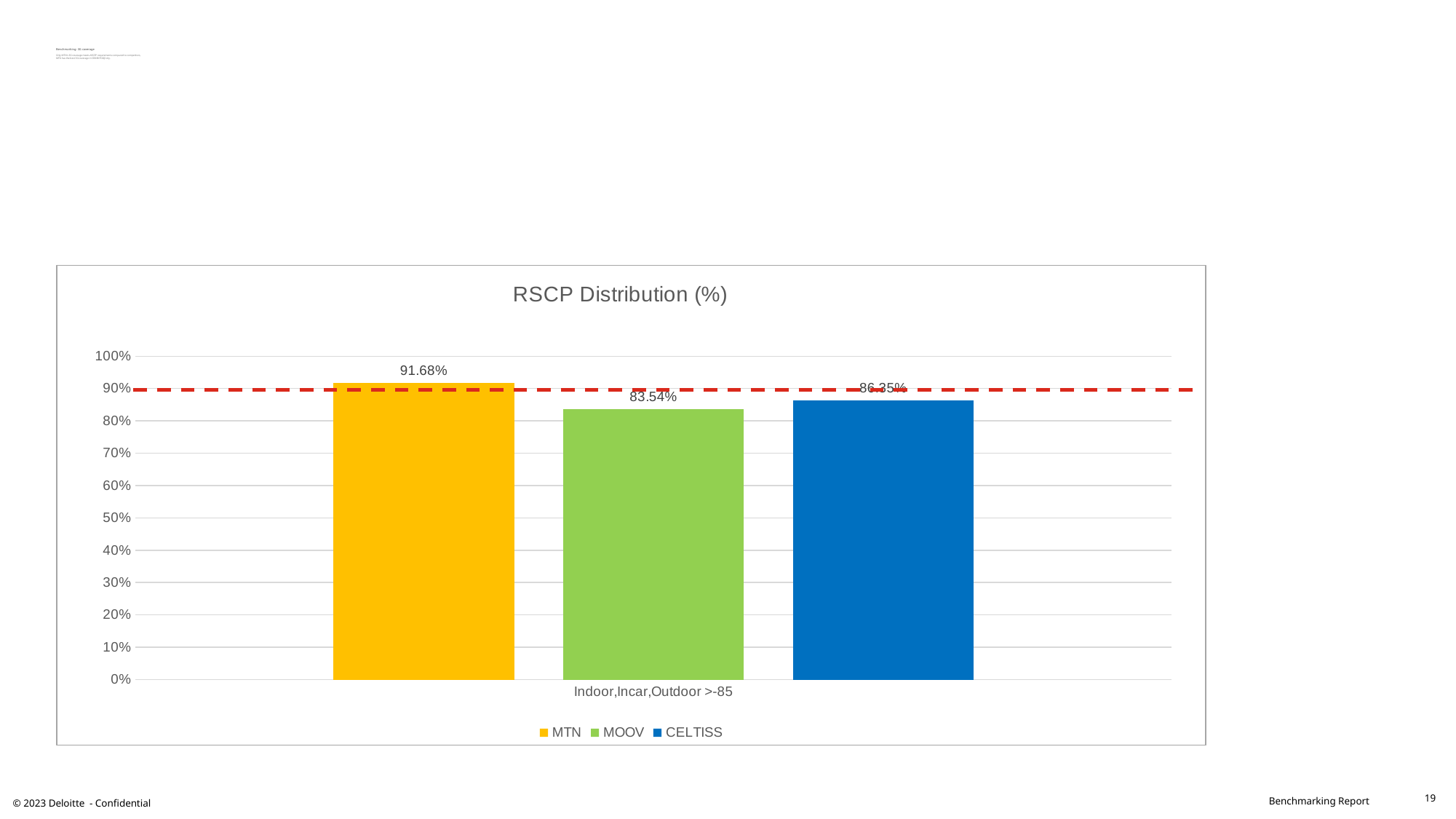
How many series does the legend of the RSCP Distribution (%) chart list? 3 Which operator has the lowest value in the RSCP Distribution (%) chart? MOOV Which is larger in the RSCP Distribution (%) chart, the value for CELTISS or the value for MOOV? CELTISS What is the difference between the MTN and MOOV values in the RSCP Distribution (%) chart? 8.14% What is the category label on the x axis of the RSCP Distribution (%) chart? Indoor,Incar,Outdoor >-85 Is the value for CELTISS in the RSCP Distribution (%) chart greater or less than 90%? less What kind of chart is the RSCP Distribution (%) chart? Bar chart Which operator has the highest value in the RSCP Distribution (%) chart? MTN What is the value for MOOV in the RSCP Distribution (%) chart? 83.54% What is the value for CELTISS in the RSCP Distribution (%) chart? 86.35% Is the value for MTN in the RSCP Distribution (%) chart greater or less than 90%? greater What is the value for MTN in the RSCP Distribution (%) chart? 91.68%